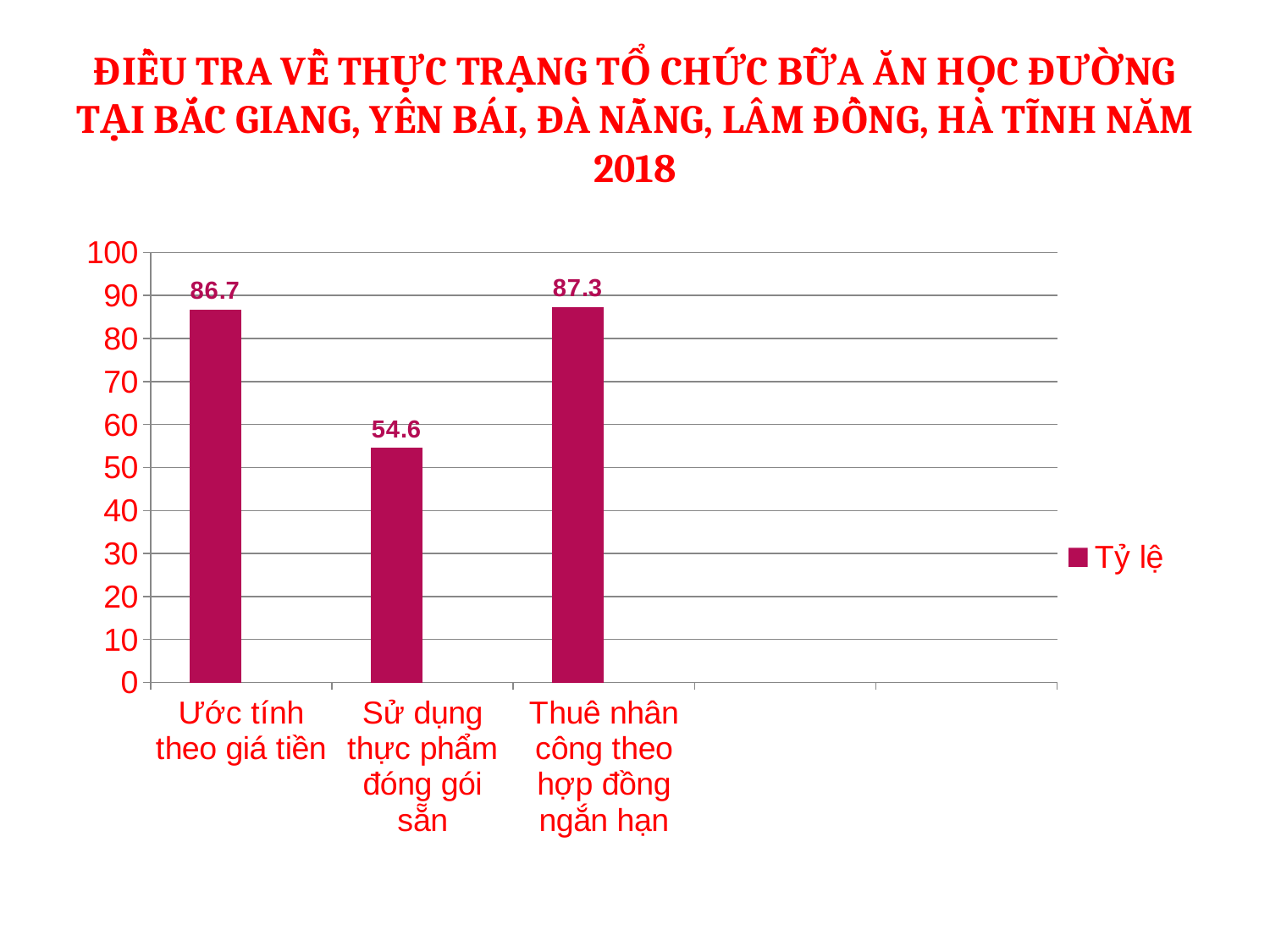
What kind of chart is shown on the slide? bar chart Which category has the highest value? Thuê nhân công theo hợp đồng ngắn hạn Which is larger: the value for "Ước tính theo giá tiền" or the value for "Sử dụng thực phẩm đóng gói sẵn"? Ước tính theo giá tiền What is the value for "Ước tính theo giá tiền"? 86.7 What is the value for "Sử dụng thực phẩm đóng gói sẵn"? 54.6 What is the value for "Thuê nhân công theo hợp đồng ngắn hạn"? 87.3 What is the difference between the values for "Thuê nhân công theo hợp đồng ngắn hạn" and "Sử dụng thực phẩm đóng gói sẵn"? 32.7 What is the difference between the values for "Ước tính theo giá tiền" and "Sử dụng thực phẩm đóng gói sẵn"? 32.1 How many categories are shown on the x axis? 3 Is the value for "Sử dụng thực phẩm đóng gói sẵn" greater or less than 60? less How many series does the legend list? 1 Which category has the lowest value? Sử dụng thực phẩm đóng gói sẵn